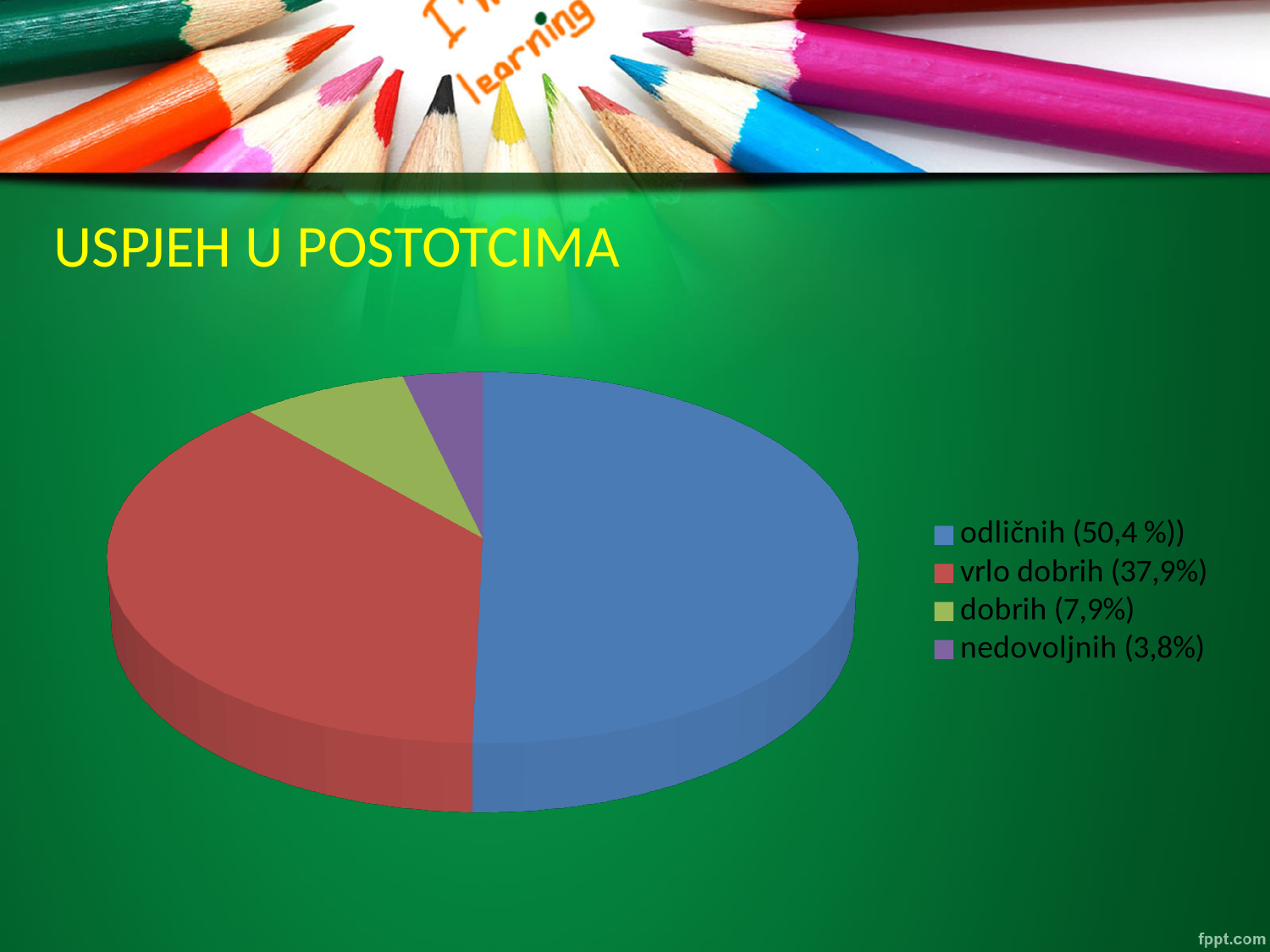
What colour is the slice for 'odličnih'? blue Which category has the largest slice of the pie? odličnih Which category has the smallest slice of the pie? nedovoljnih What is the difference in percentage points between 'odličnih' and 'vrlo dobrih'? 12,5 What is the chart's title? USPJEH U POSTOTCIMA Which is larger, the slice for 'vrlo dobrih' or the slice for 'dobrih'? vrlo dobrih What percentage is shown for 'dobrih' in the legend? 7,9% What kind of chart is shown on the slide? pie chart What percentage is shown for 'vrlo dobrih' in the legend? 37,9% How many slices does the pie chart have? 4 What percentage is shown for 'nedovoljnih' in the legend? 3,8% What is the difference in percentage points between 'dobrih' and 'nedovoljnih'? 4,1